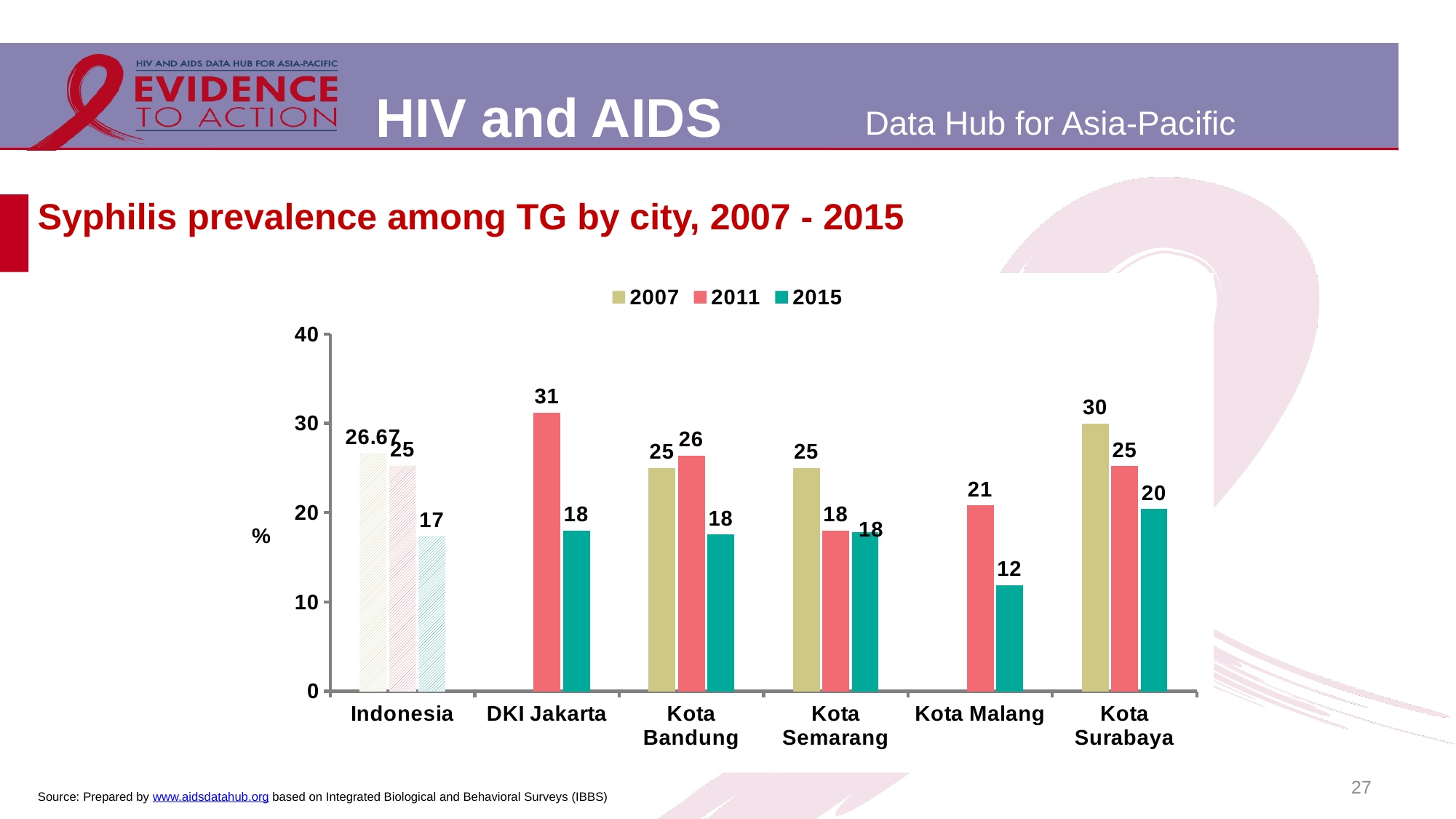
What kind of chart is shown on the slide? bar chart Do the values for Kota Surabaya rise or fall from 2007 to 2015? fall What is the difference between the 2007 and 2015 values for Kota Surabaya? 10 Which category has the lowest 2015 value? Kota Malang What is the 2011 value for DKI Jakarta? 31 How many categories are shown on the x axis? 6 How many series does the legend list? 3 What is the 2015 value for Kota Malang? 12 What is the difference between the 2011 and 2015 values for DKI Jakarta? 13 What is the 2007 value for Indonesia? 26.67 For Kota Bandung, which year has the larger value, 2007 or 2011? 2011 Which city has the highest 2011 value? DKI Jakarta